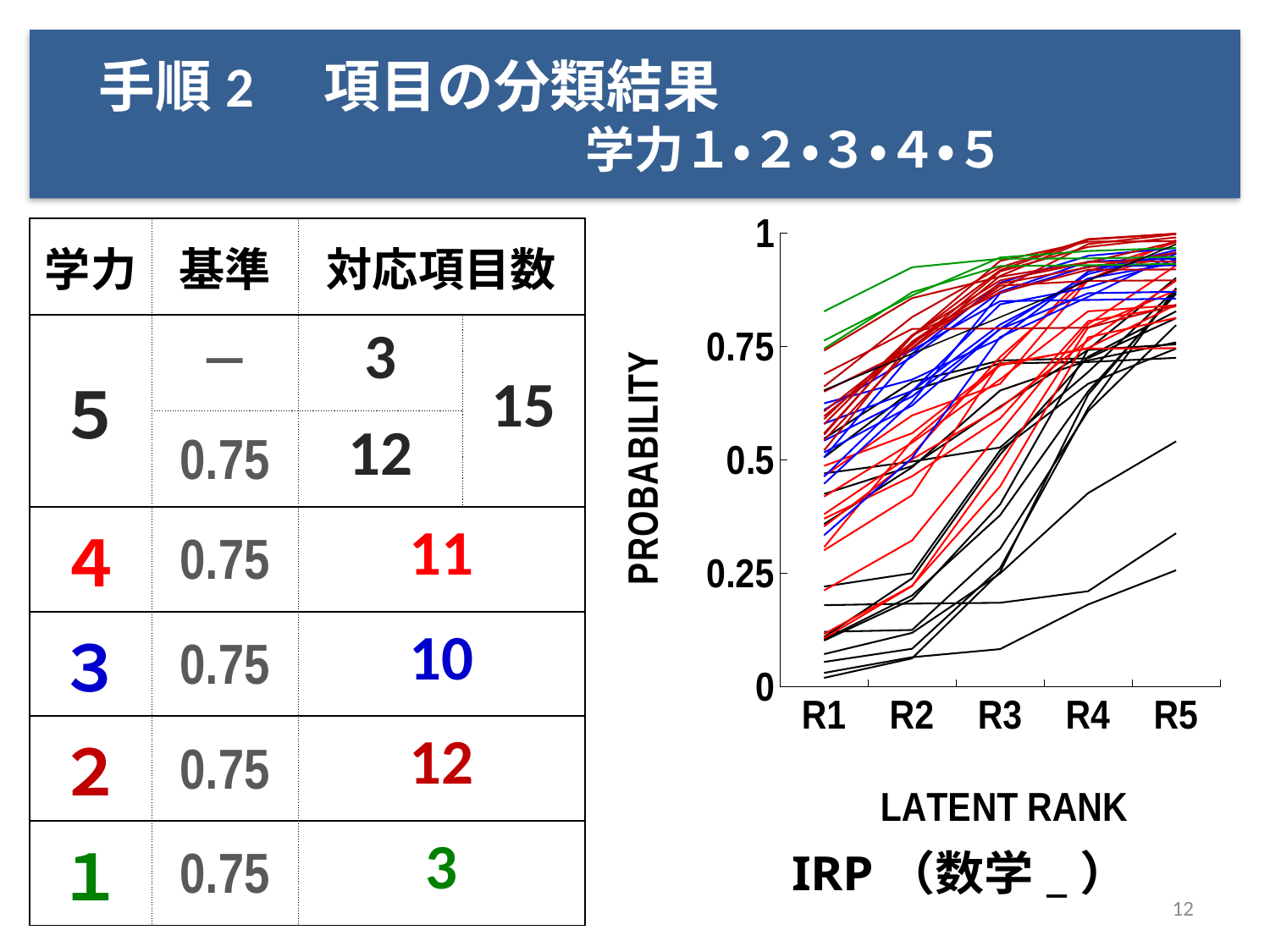
What is the last category on the x axis of the IRP chart? R5 How many latent ranks are shown on the x axis of the IRP chart? 5 What is the first category on the x axis of the IRP chart? R1 What is the label of the x axis of the IRP chart? LATENT RANK What kind of chart is the IRP (数学_) chart on the right of the slide? line chart Do the lines in the IRP chart generally rise or fall from R1 to R5? rise What is the label of the y axis of the IRP chart? PROBABILITY